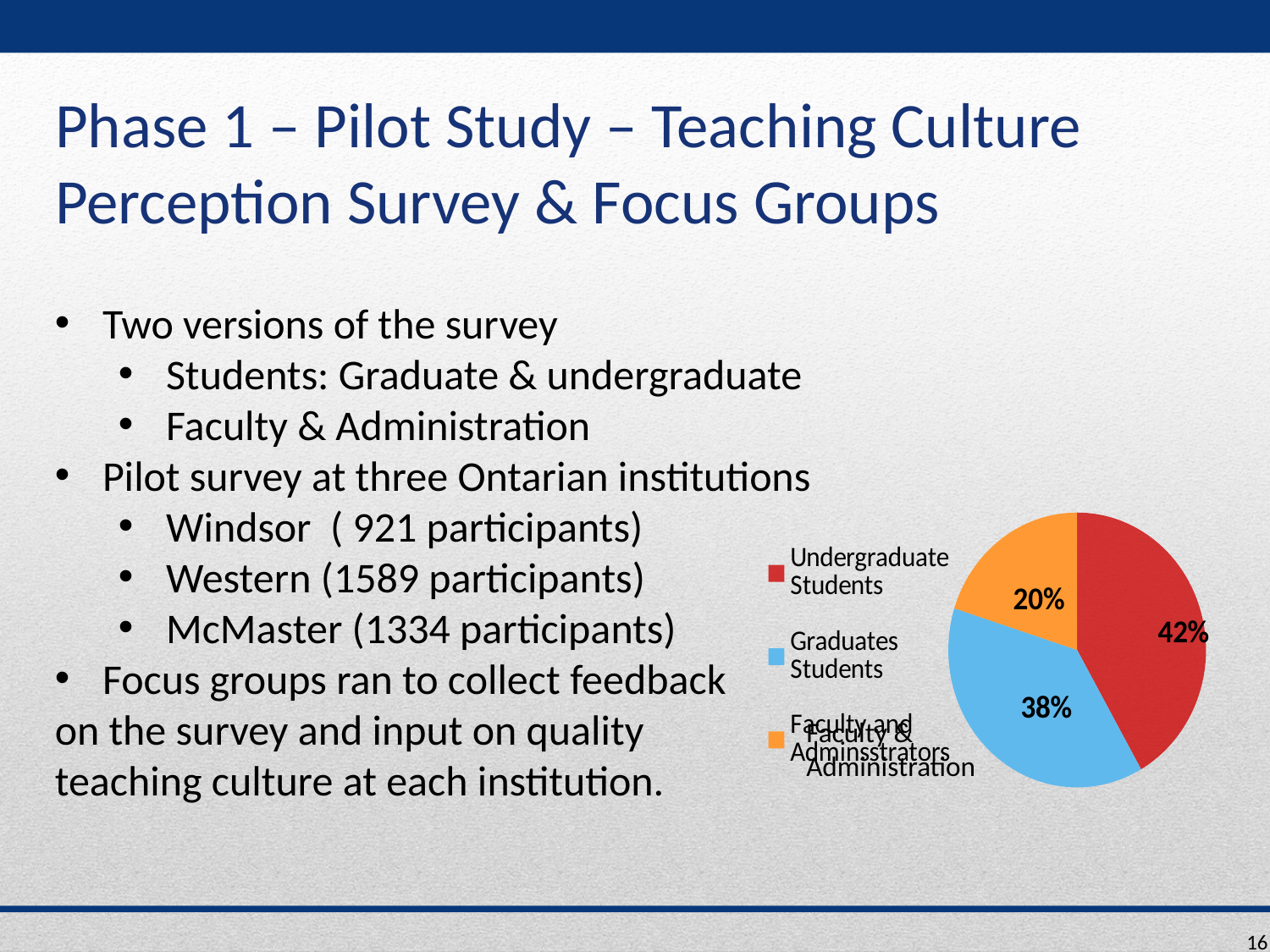
Which is larger in the pie chart, Graduates Students or Faculty & Administration? Graduates Students Which slice of the pie chart is the largest? Undergraduate Students What is the difference in percentage points between the Undergraduate Students slice and the Graduates Students slice? 4 How many entries does the pie chart's legend list? 3 Which slice of the pie chart is the smallest? Faculty & Administration What percentage of the pie chart is Undergraduate Students? 42% What colour is the Undergraduate Students slice in the pie chart? red What percentage of the pie chart is the Faculty & Administration slice? 20% What is the difference in percentage points between the Undergraduate Students slice and the Faculty & Administration slice? 22 What percentage of the pie chart is Graduates Students? 38% How many slices does the pie chart have? 3 What kind of chart is shown on the slide? pie chart